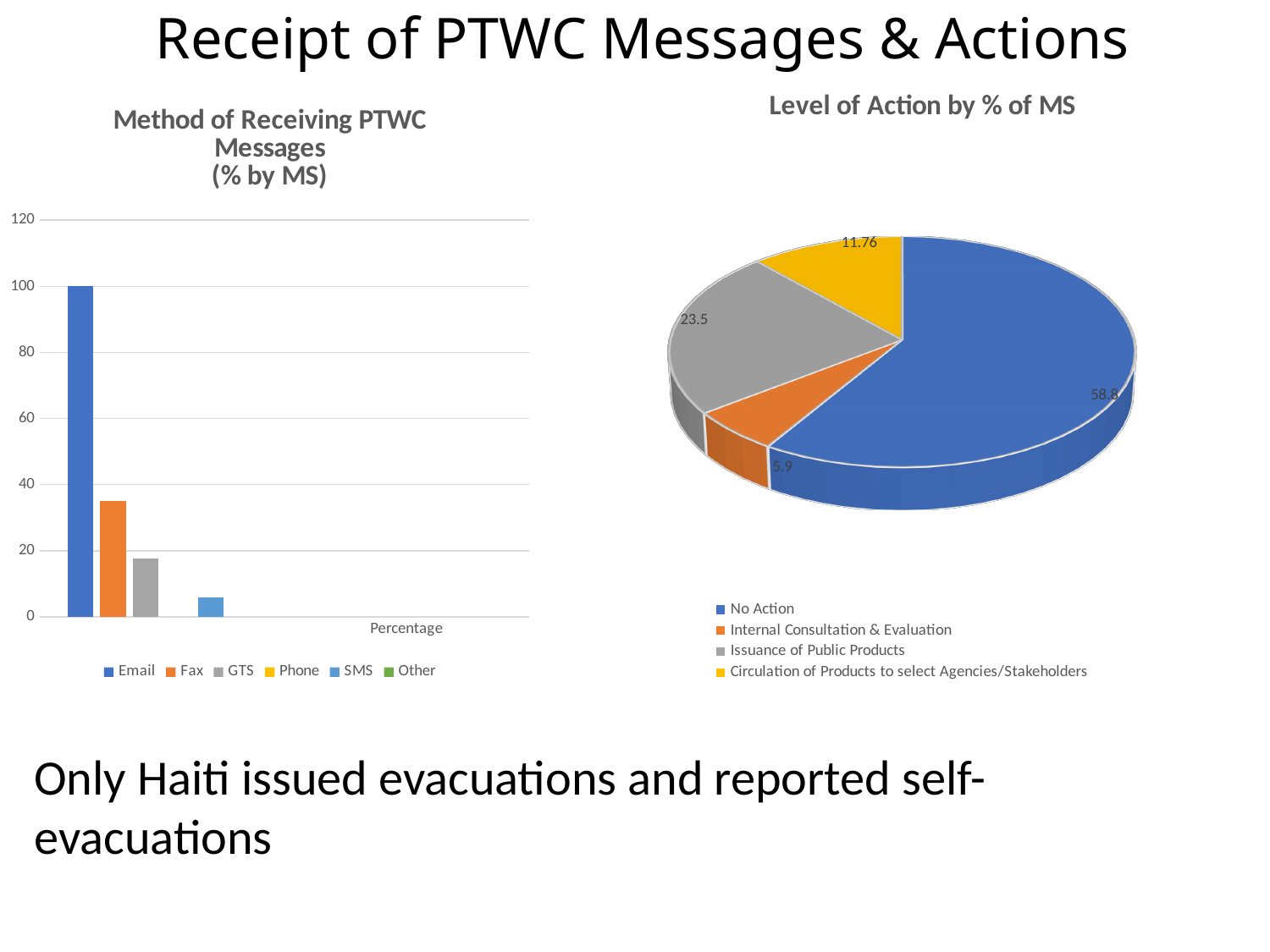
In the 'Level of Action by % of MS' pie chart, what is the value for No Action? 58.8 In the 'Level of Action by % of MS' pie chart, which category has the smallest slice? Internal Consultation & Evaluation In the 'Method of Receiving PTWC Messages' chart, which is larger, Fax or GTS? Fax How many series does the legend of the 'Method of Receiving PTWC Messages' chart list? 6 In the 'Method of Receiving PTWC Messages' chart, what is the value for Email? 100 In the 'Level of Action by % of MS' pie chart, what is the difference between No Action and Issuance of Public Products? 35.3 In the 'Method of Receiving PTWC Messages' chart, is the value for SMS greater or less than 20? less What kind of chart is the 'Level of Action by % of MS' chart on the right? pie chart What kind of chart is the 'Method of Receiving PTWC Messages (% by MS)' chart on the left? bar chart In the 'Method of Receiving PTWC Messages' chart, which method has the highest value? Email In the 'Level of Action by % of MS' pie chart, what is the value for Issuance of Public Products? 23.5 In the 'Method of Receiving PTWC Messages' chart, is the value for Fax greater or less than 20? greater